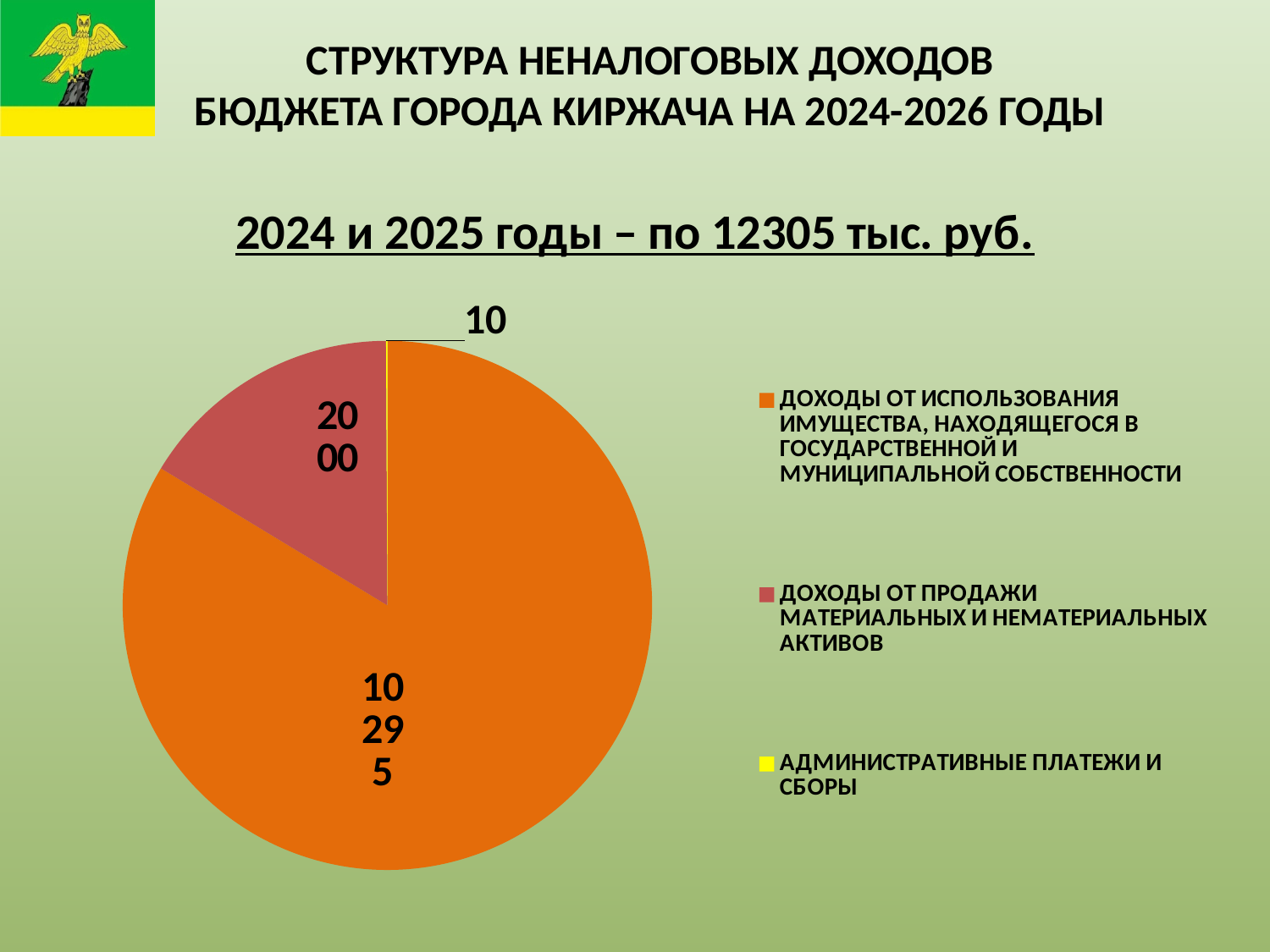
What is the value for ДОХОДЫ ОТ ИСПОЛЬЗОВАНИЯ ИМУЩЕСТВА, НАХОДЯЩЕГОСЯ В ГОСУДАРСТВЕННОЙ И МУНИЦИПАЛЬНОЙ СОБСТВЕННОСТИ? 10295 How many entries does the legend of the pie chart list? 3 Which is larger: the value for ДОХОДЫ ОТ ПРОДАЖИ МАТЕРИАЛЬНЫХ И НЕМАТЕРИАЛЬНЫХ АКТИВОВ or the value for АДМИНИСТРАТИВНЫЕ ПЛАТЕЖИ И СБОРЫ? ДОХОДЫ ОТ ПРОДАЖИ МАТЕРИАЛЬНЫХ И НЕМАТЕРИАЛЬНЫХ АКТИВОВ What is the value for АДМИНИСТРАТИВНЫЕ ПЛАТЕЖИ И СБОРЫ? 10 How many slices does the pie chart have? 3 What is the difference between the value for ДОХОДЫ ОТ ИСПОЛЬЗОВАНИЯ ИМУЩЕСТВА and the value for ДОХОДЫ ОТ ПРОДАЖИ МАТЕРИАЛЬНЫХ И НЕМАТЕРИАЛЬНЫХ АКТИВОВ? 8295 Which category has the largest slice of the pie? ДОХОДЫ ОТ ИСПОЛЬЗОВАНИЯ ИМУЩЕСТВА, НАХОДЯЩЕГОСЯ В ГОСУДАРСТВЕННОЙ И МУНИЦИПАЛЬНОЙ СОБСТВЕННОСТИ What colour is the slice for АДМИНИСТРАТИВНЫЕ ПЛАТЕЖИ И СБОРЫ? yellow What is the value for ДОХОДЫ ОТ ПРОДАЖИ МАТЕРИАЛЬНЫХ И НЕМАТЕРИАЛЬНЫХ АКТИВОВ? 2000 What kind of chart is shown on the slide? pie chart Which category has the smallest slice of the pie? АДМИНИСТРАТИВНЫЕ ПЛАТЕЖИ И СБОРЫ What is the total of all slices in the pie chart? 12305